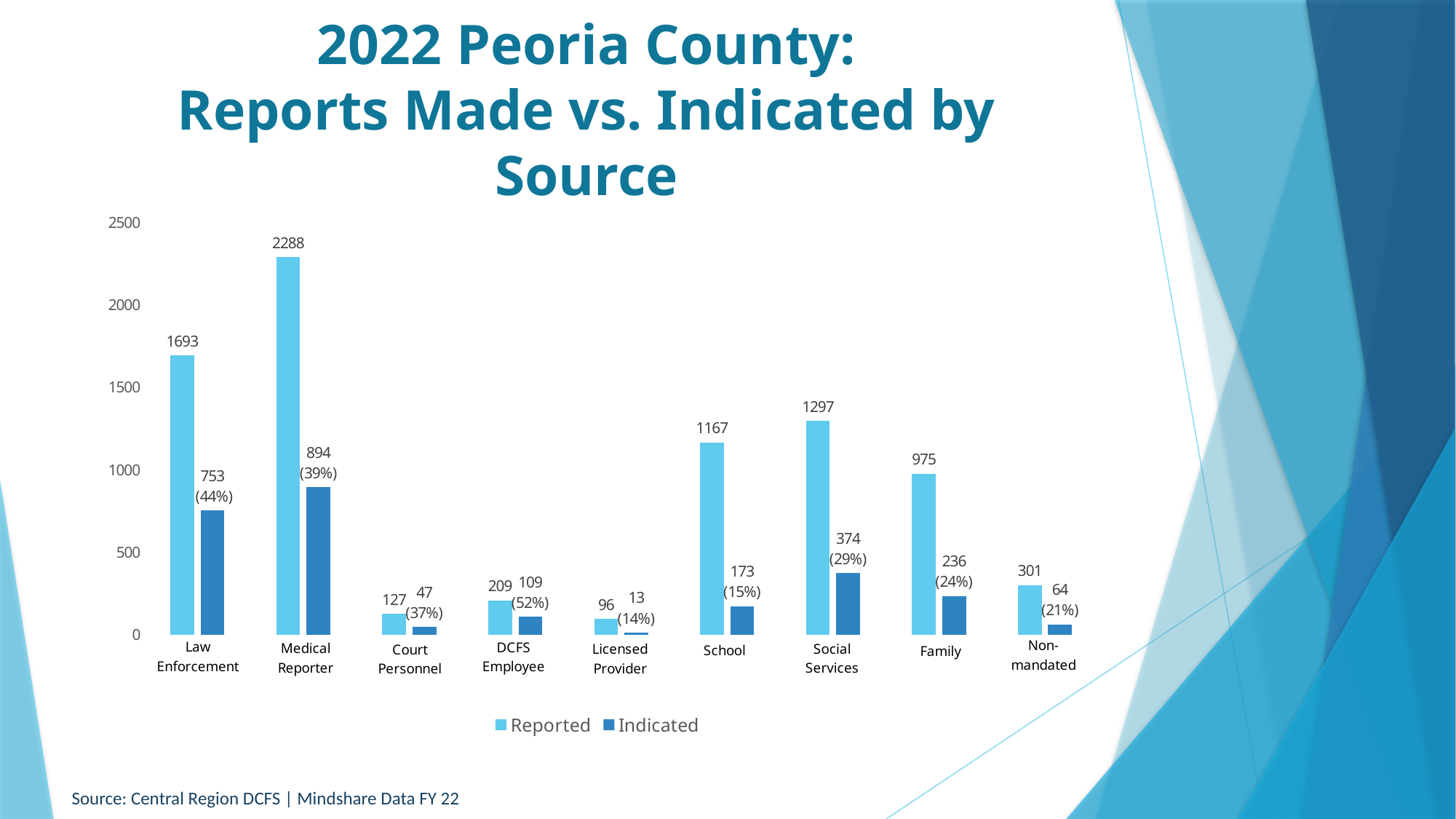
What is the difference between the Reported and Indicated values for School? 994 What is the Reported value for Medical Reporter? 2288 What is the Reported value for Licensed Provider? 96 How many sources are shown on the x axis? 9 What kind of chart is shown on the slide? Bar chart Which source has the highest Reported value? Medical Reporter Which source has the lowest Indicated value? Licensed Provider How many series does the legend list? 2 What percentage is shown next to the Indicated value for DCFS Employee? 52% What is the Indicated value for Law Enforcement? 753 What is the source cited at the bottom of the slide? Central Region DCFS | Mindshare Data FY 22 Which is larger, the Reported value for Social Services or the Reported value for School? Social Services